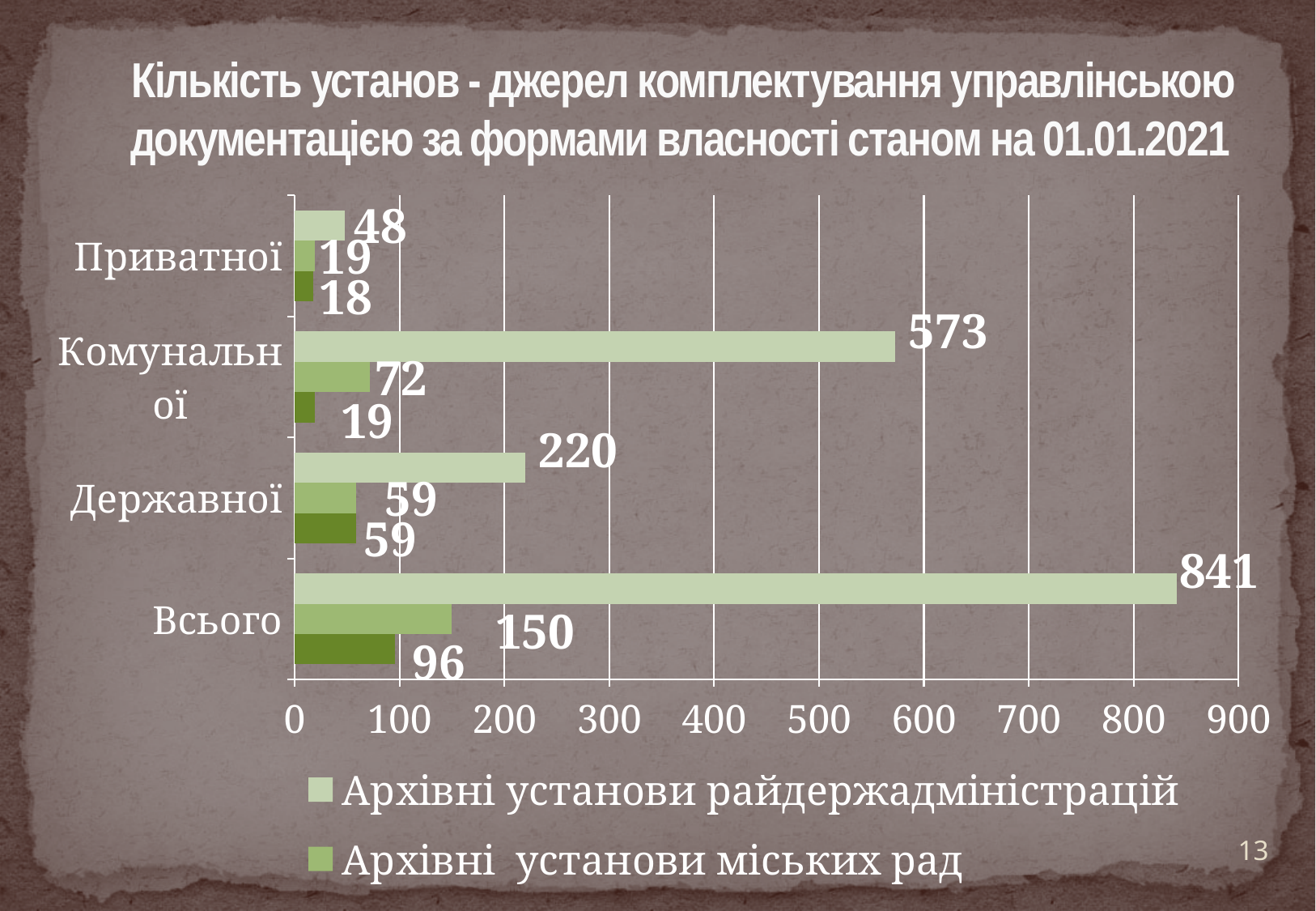
In the series Архівні установи райдержадміністрацій, which is larger: Державної or Комунальної? Комунальної What is the value for Комунальної in the series Архівні установи райдержадміністрацій? 573 How many series does the legend list? 2 What is the difference between the two labelled series values for Всього (841 and 150)? 691 Which category has the highest value in the series Архівні установи райдержадміністрацій? Всього What is the difference between Комунальної and Державної in the series Архівні установи райдержадміністрацій? 353 What is the value for Державної in the series Архівні установи міських рад? 59 What kind of chart is shown on the slide? bar chart What is the value for Приватної in the series Архівні установи райдержадміністрацій? 48 What is the value for Всього in the series Архівні установи міських рад? 150 How many categories are shown on the vertical axis of the chart? 4 Which category has the lowest value in the series Архівні установи міських рад? Приватної